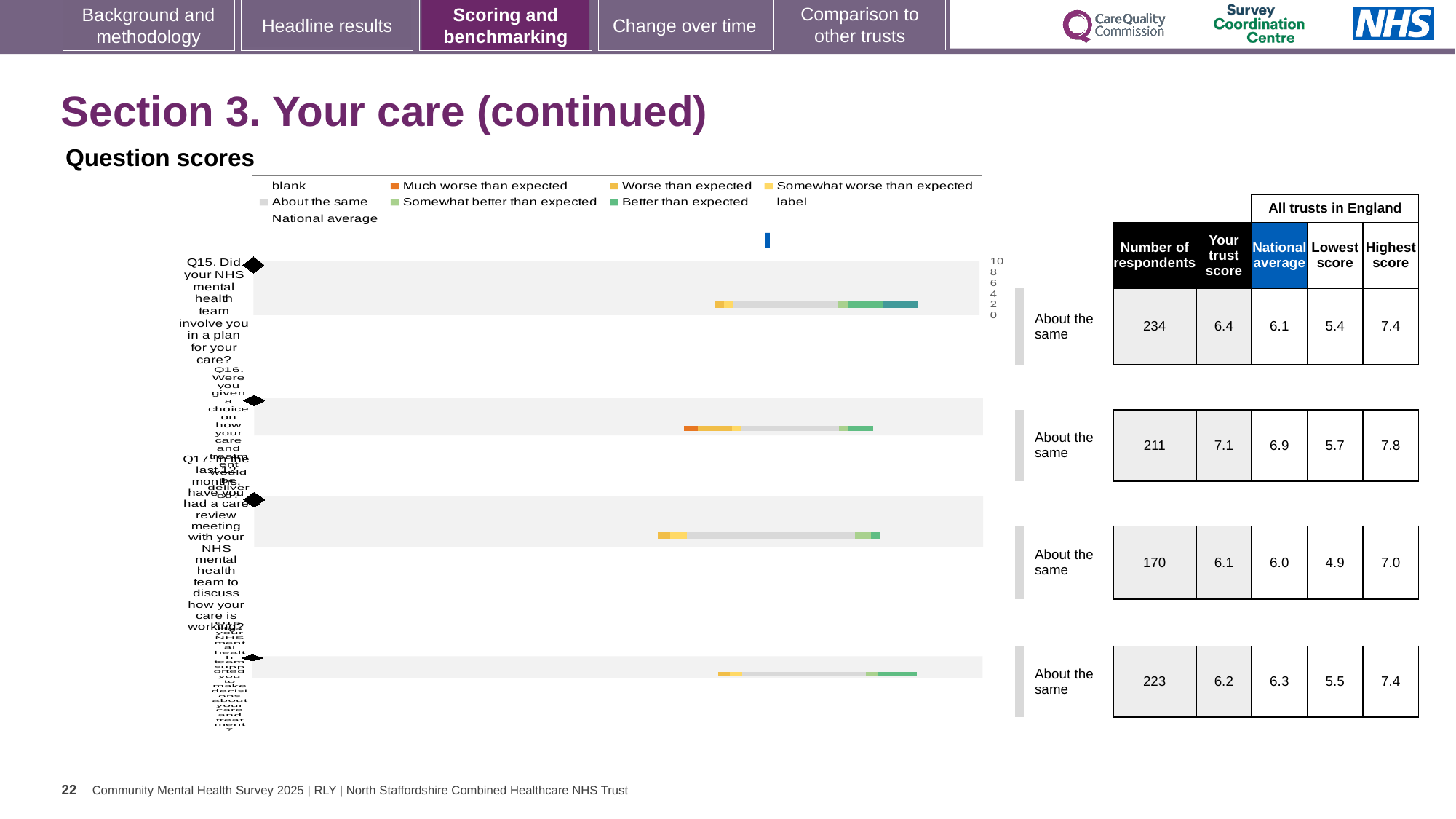
What colour does the legend use for 'Much worse than expected'? Orange What is the difference between the highest score and the lowest score for Q15? 2.0 By how much does the trust score for Q17 exceed the national average? 0.1 How many questions are plotted as bars in the question scores chart? 4 For Q16, which is larger: the trust score or the national average? Trust score (7.1) What kind of chart is used to show the question scores on this slide? Bar chart How is the trust's result for Q15 categorised compared with expectations? About the same What is the lowest score among all trusts in England for Q17? 4.9 What is the national average for Q16 (Were you given a choice on how your care and treatment would be delivered)? 6.9 Which question has the highest trust score? Q16 (7.1) How many respondents answered Q17 (In the last 12 months, have you had a care review meeting)? 170 What is the trust score for Q15 (Did your NHS mental health team involve you in a plan for your care?)? 6.4